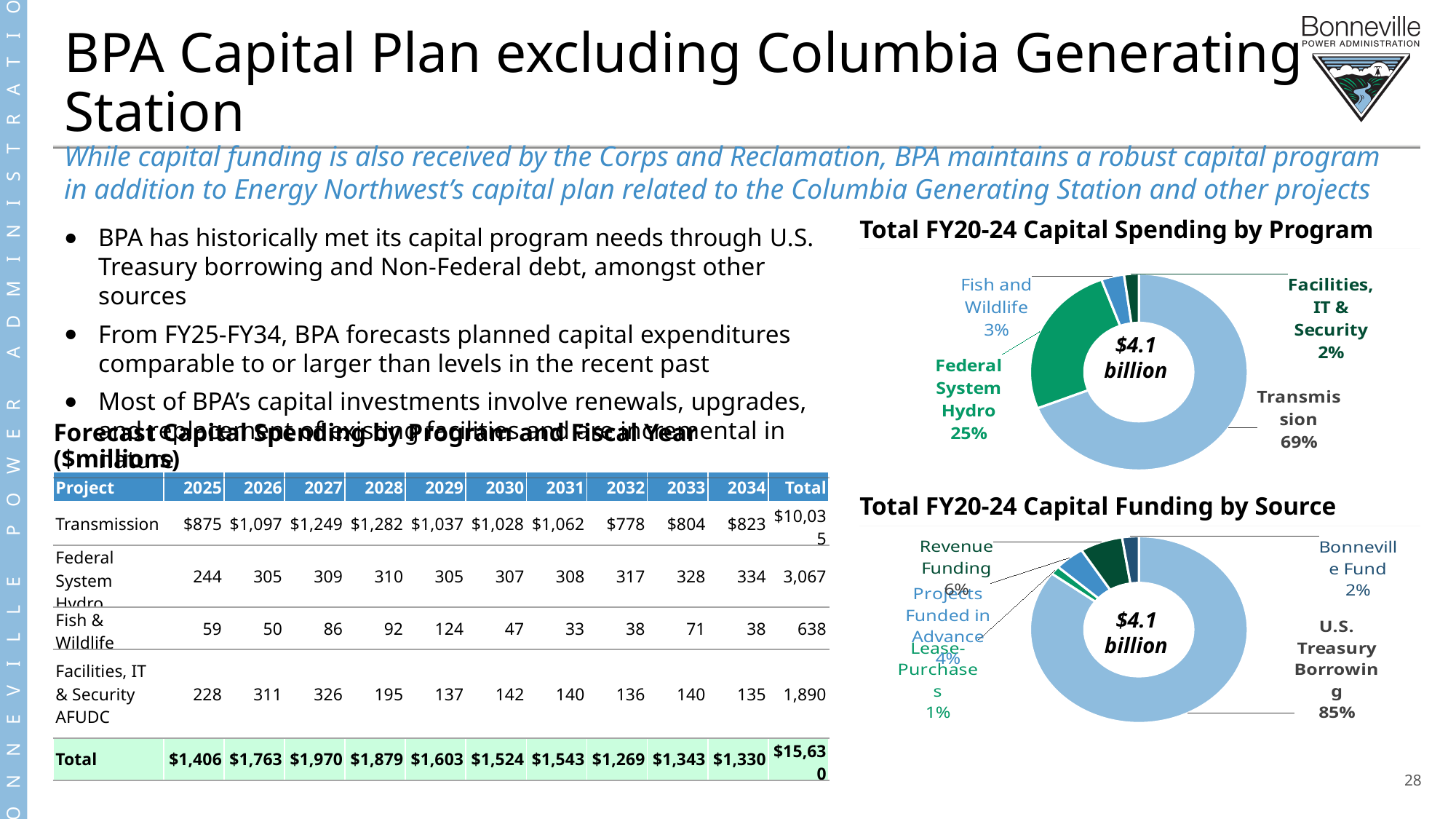
In the 'Total FY20-24 Capital Funding by Source' chart, which is larger: Projects Funded in Advance or Bonneville Fund? Projects Funded in Advance In the 'Total FY20-24 Capital Funding by Source' chart, what share does Revenue Funding have? 6% How many labelled funding sources are shown in the 'Total FY20-24 Capital Funding by Source' chart? 5 In the 'Total FY20-24 Capital Spending by Program' chart, which program has the smallest share? Facilities, IT & Security In the 'Total FY20-24 Capital Spending by Program' chart, what share does Federal System Hydro have? 25% In the 'Total FY20-24 Capital Spending by Program' chart, what is the difference in percentage points between Transmission and Federal System Hydro? 44 percentage points What total amount is shown in the centre of the 'Total FY20-24 Capital Spending by Program' chart? $4.1 billion What kind of chart is 'Total FY20-24 Capital Funding by Source'? Pie (donut) chart In the 'Total FY20-24 Capital Funding by Source' chart, what share does U.S. Treasury Borrowing have? 85% In the 'Total FY20-24 Capital Funding by Source' chart, which source has the smallest share? Lease-Purchases In the 'Total FY20-24 Capital Spending by Program' chart, which program has the largest share? Transmission